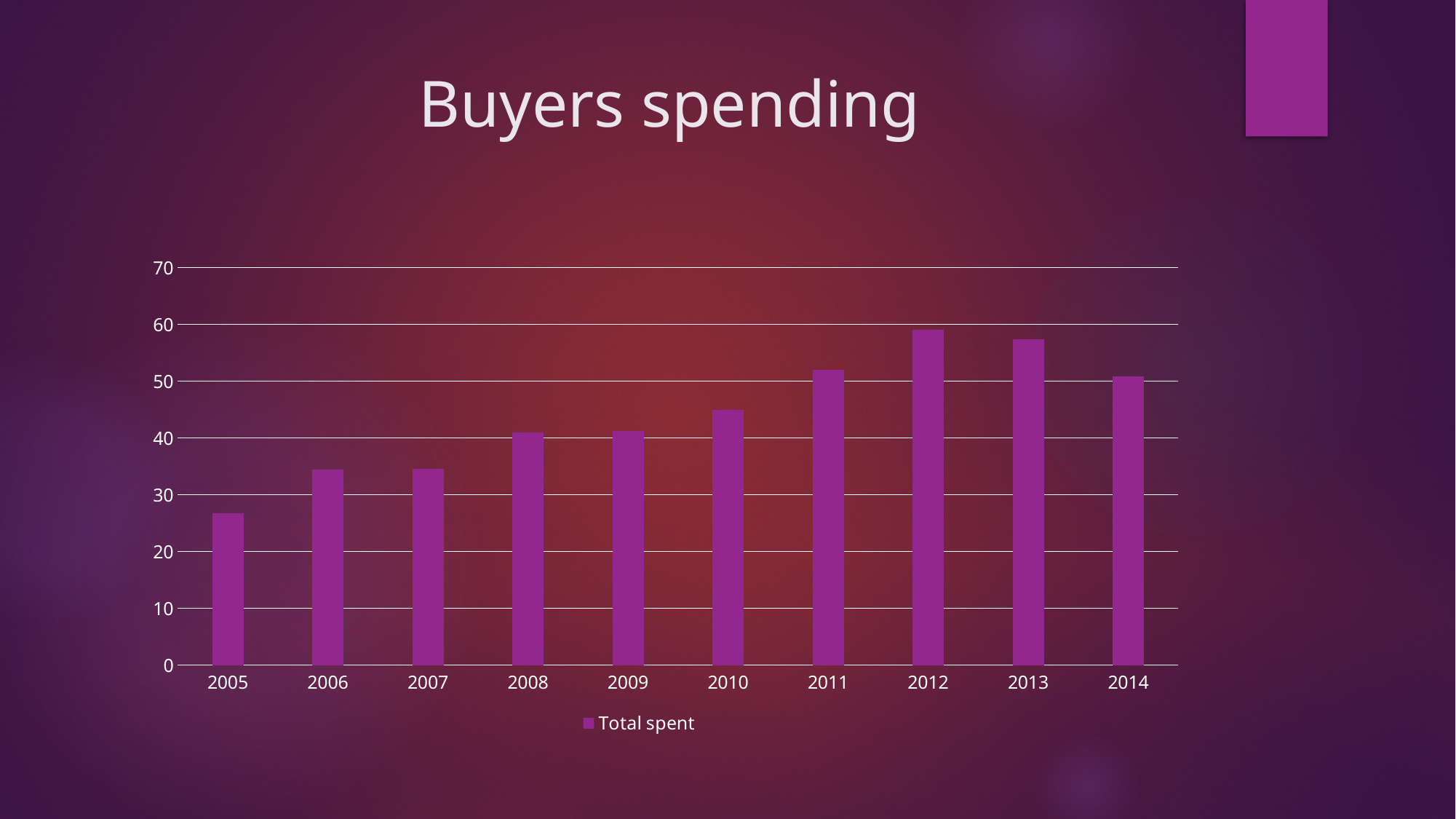
How many years are shown on the x axis? 10 Do the values rise or fall from 2005 to 2012? rise What kind of chart is shown on the slide? bar chart Is the value for 2009 greater or less than 50? less Which year has the lowest Total spent? 2005 Which year has the highest Total spent? 2012 Is the value for 2010 greater or less than 40? greater Which is larger, the value for 2010 or the value for 2011? 2011 How many series does the legend list? 1 What is the title of the chart? Buyers spending Is the value for 2005 greater or less than 30? less